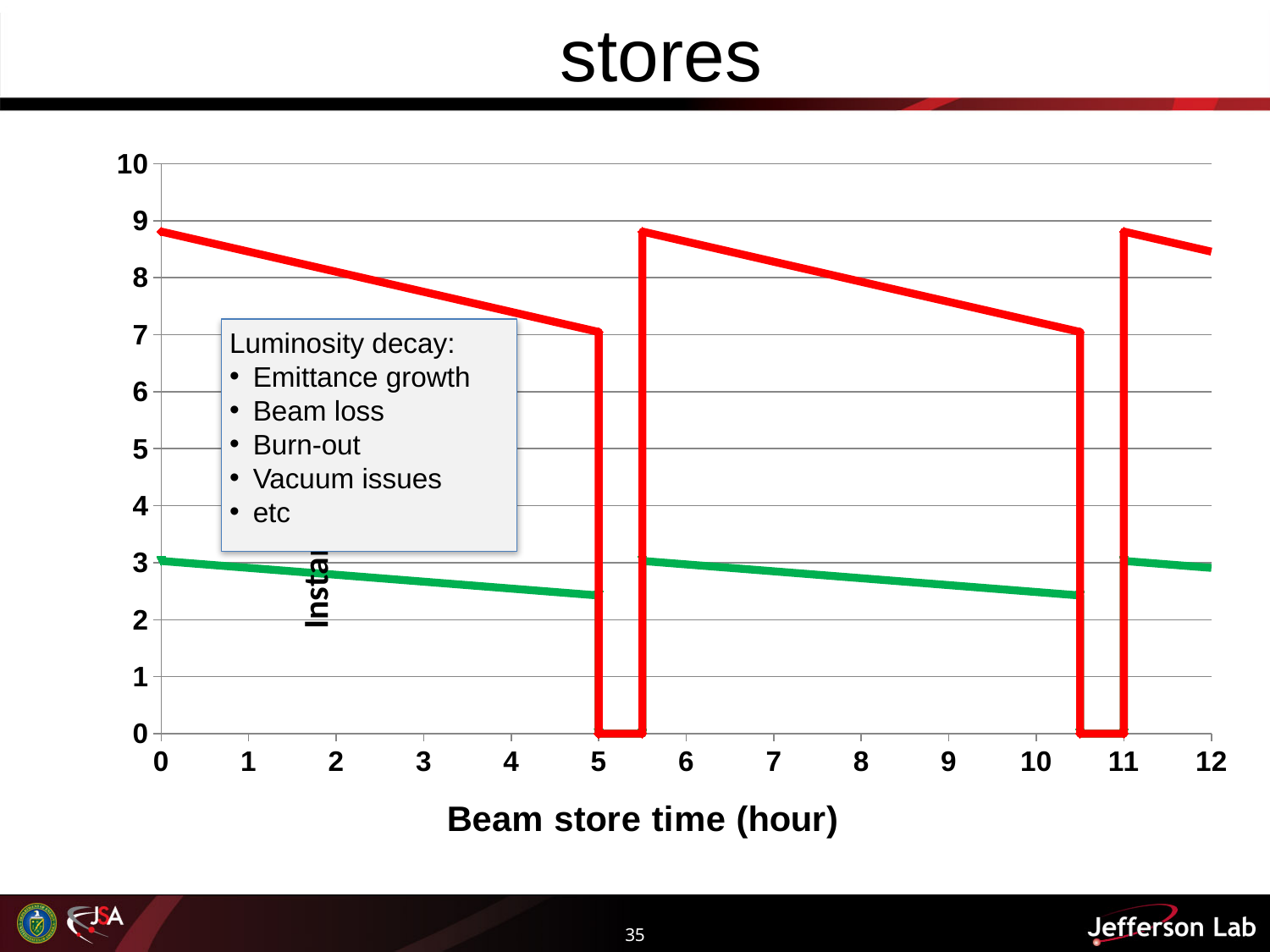
Is the value of the red line at hour 3 greater or less than 8? less Which line has the higher value at hour 2, the red line or the green line? red line Between hour 0 and hour 5, does the red line rise or fall as beam store time increases? fall What is the highest value shown on the x axis of the chart? 12 How many lines (series) are plotted on the chart? 2 Is the value of the green line at hour 4 greater or less than 3? less What is the title of the x axis of the chart? Beam store time (hour) Is the value of the red line at hour 0 greater or less than 8? greater What kind of chart is shown on the slide? line chart What value does the red line take between hour 5 and hour 5.5? 0 What value does the red line take between hour 10.5 and hour 11? 0